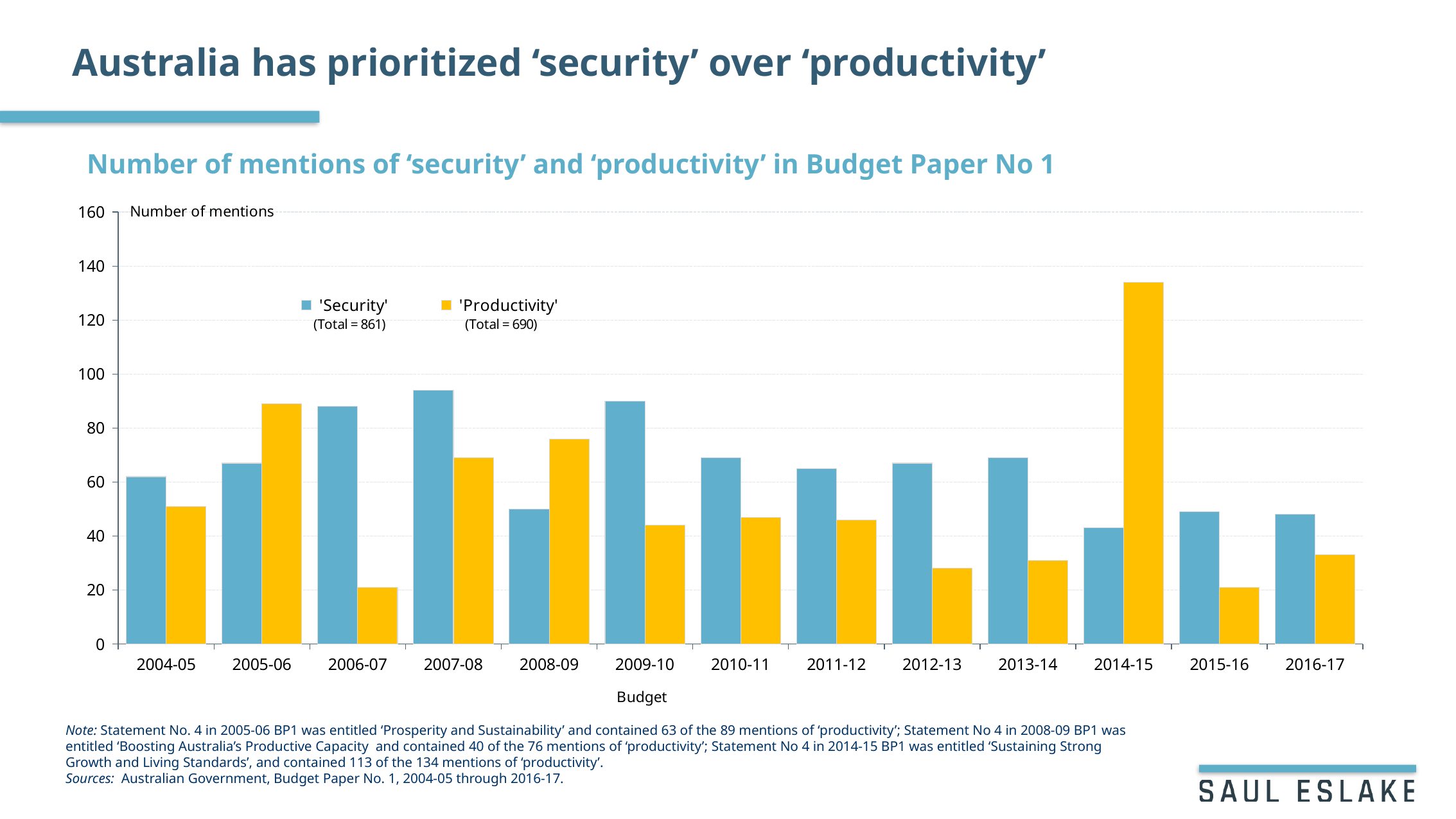
According to the slide, how many mentions of 'productivity' were there in the 2014-15 Budget Paper No 1? 134 What kind of chart is shown on the slide? bar chart What is the difference between the total mentions of 'Security' (861) and 'Productivity' (690) shown in the legend? 171 How many series does the legend list? 2 Is the 'Productivity' value for 2006-07 greater or less than 40? less In which budget year is the 'Security' bar highest? 2007-08 According to the slide, how many mentions of 'productivity' were there in the 2005-06 Budget Paper No 1? 89 In which budget year is the 'Productivity' bar highest? 2014-15 How many budget years are shown on the x axis? 13 Is the 'Productivity' value for 2014-15 greater or less than 120? greater What total number of mentions does the legend give for 'Security'? 861 In 2005-06, which is larger: the 'Security' bar or the 'Productivity' bar? 'Productivity'